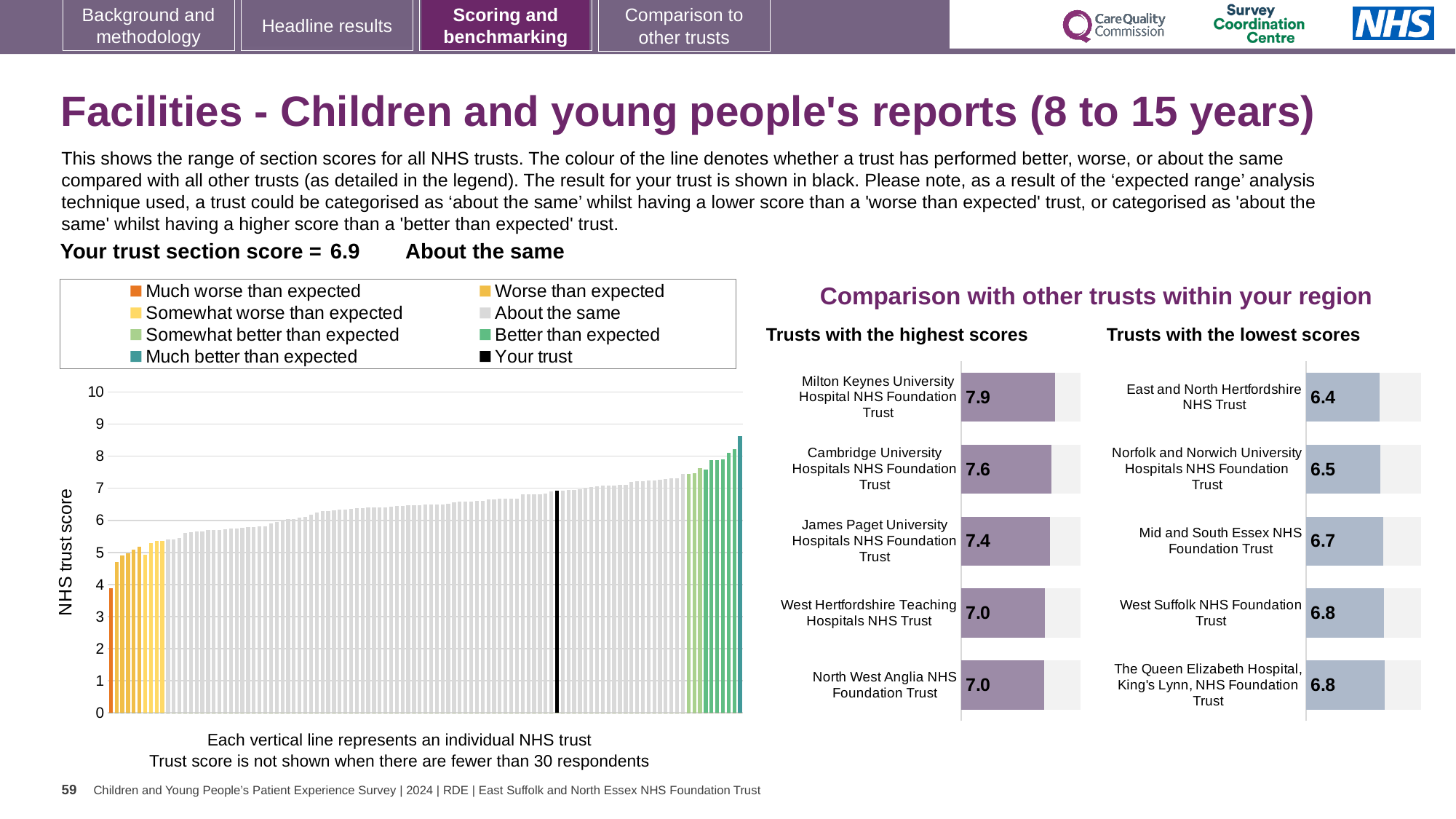
In the 'Trusts with the lowest scores' chart, which trust has the lowest score? East and North Hertfordshire NHS Trust In the NHS trust score chart on the left, what colour is used for 'Your trust' according to the legend? Black In the 'Trusts with the lowest scores' chart, what is the score for East and North Hertfordshire NHS Trust? 6.4 In the 'Trusts with the highest scores' chart, what is the difference between the scores of Milton Keynes University Hospital NHS Foundation Trust and Cambridge University Hospitals NHS Foundation Trust? 0.3 In the NHS trust score chart on the left, do the bar values rise or fall from left to right? Rise How many trusts are shown in the 'Trusts with the highest scores' chart? 5 In the 'Trusts with the highest scores' chart, what is the score for Milton Keynes University Hospital NHS Foundation Trust? 7.9 In the NHS trust score chart on the left, is the value of the tallest bar greater or less than 8? greater Which has the higher score: James Paget University Hospitals NHS Foundation Trust in the highest scores chart, or Mid and South Essex NHS Foundation Trust in the lowest scores chart? James Paget University Hospitals NHS Foundation Trust How many entries does the legend of the NHS trust score chart on the left list? 8 In the 'Trusts with the highest scores' chart, which trust has the highest score? Milton Keynes University Hospital NHS Foundation Trust What kind of chart is the NHS trust score chart on the left of the slide? Bar chart